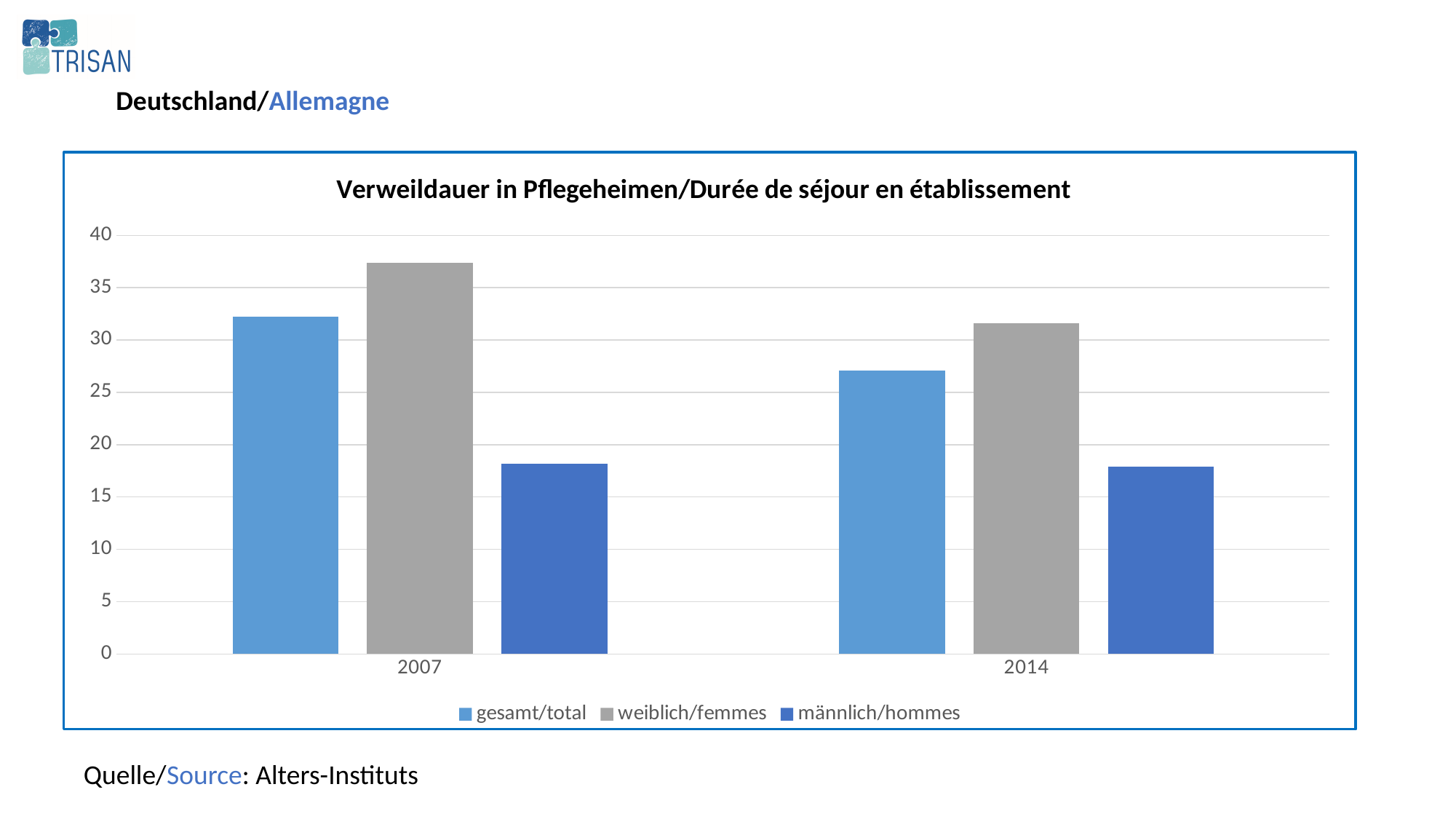
Is the value for männlich/hommes in 2007 greater or less than 20? less What is the title of the chart? Verweildauer in Pflegeheimen/Durée de séjour en établissement Which series has the highest value in 2007? weiblich/femmes Does the weiblich/femmes value rise or fall from 2007 to 2014? fall Is the value for weiblich/femmes in 2007 greater or less than 35? greater What kind of chart is shown on the slide? bar chart How many year categories are shown on the x axis? 2 Which is larger, the gesamt/total value in 2007 or in 2014? 2007 Which series has the lowest value in 2014? männlich/hommes What colour are the bars for weiblich/femmes? grey Is the value for gesamt/total in 2014 greater or less than 30? less How many series does the legend list? 3